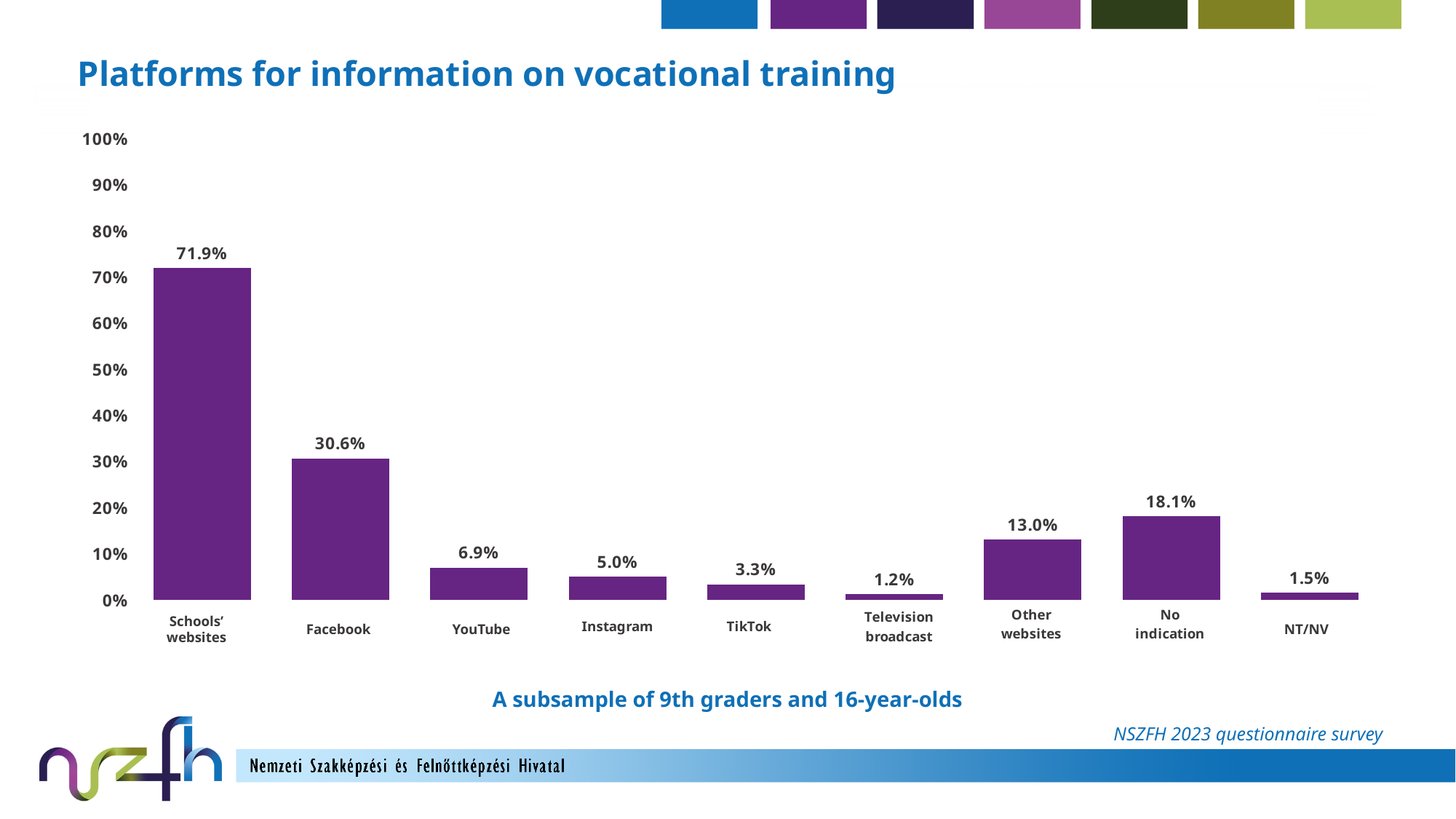
What is the value for Other websites? 13.0% What is the difference between the values for No indication and Other websites? 5.1% What is the difference between the values for Schools' websites and Facebook? 41.3% Which category has the lowest value? Television broadcast What is the value for Schools' websites? 71.9% What is the value for Facebook? 30.6% Which category has the highest value? Schools' websites What is the value for Television broadcast? 1.2% Which is larger, the value for YouTube or the value for Instagram? YouTube How many categories are shown on the x axis? 9 Is the value for Facebook greater or less than 40%? less What kind of chart is shown on the slide? Bar chart